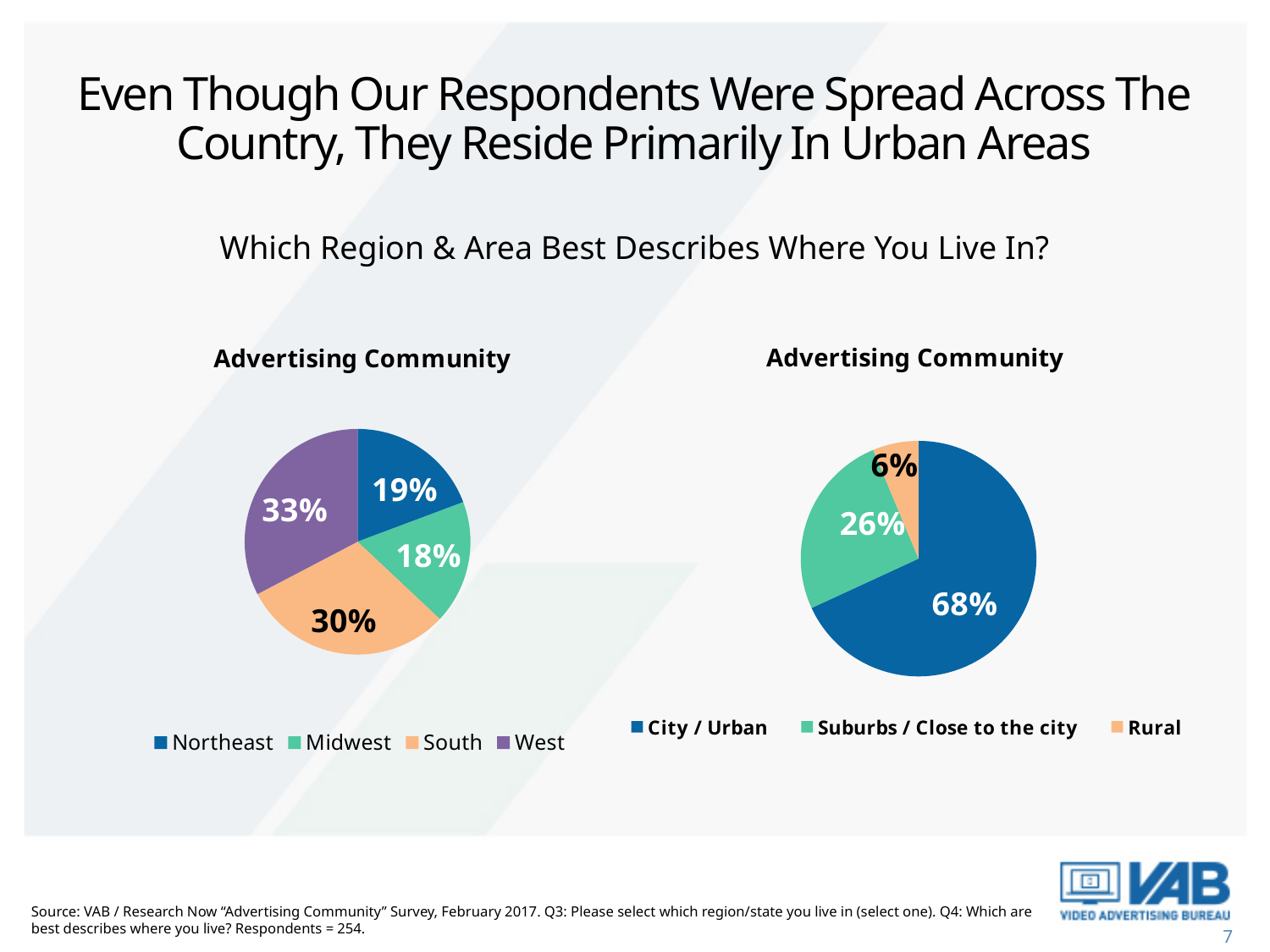
In the left pie chart, what share of respondents live in the Midwest? 18% What type of chart is used on the right side of the slide? Pie chart In the right pie chart, which area type has the smallest share? Rural In the left pie chart, what is the difference between the South and Northeast shares? 11% In the left pie chart, what share of respondents live in the West? 33% In the right pie chart, what share of respondents live in a Rural area? 6% In the left pie chart, how many regions are shown? 4 In the left pie chart, which region has the largest share of respondents? West In the right pie chart, what is the difference between the City / Urban and Suburbs / Close to the city shares? 42% In the right pie chart, which is larger: City / Urban or Suburbs / Close to the city? City / Urban In the right pie chart, what share of respondents live in a City / Urban area? 68% In the left pie chart, which region has the smallest share of respondents? Midwest